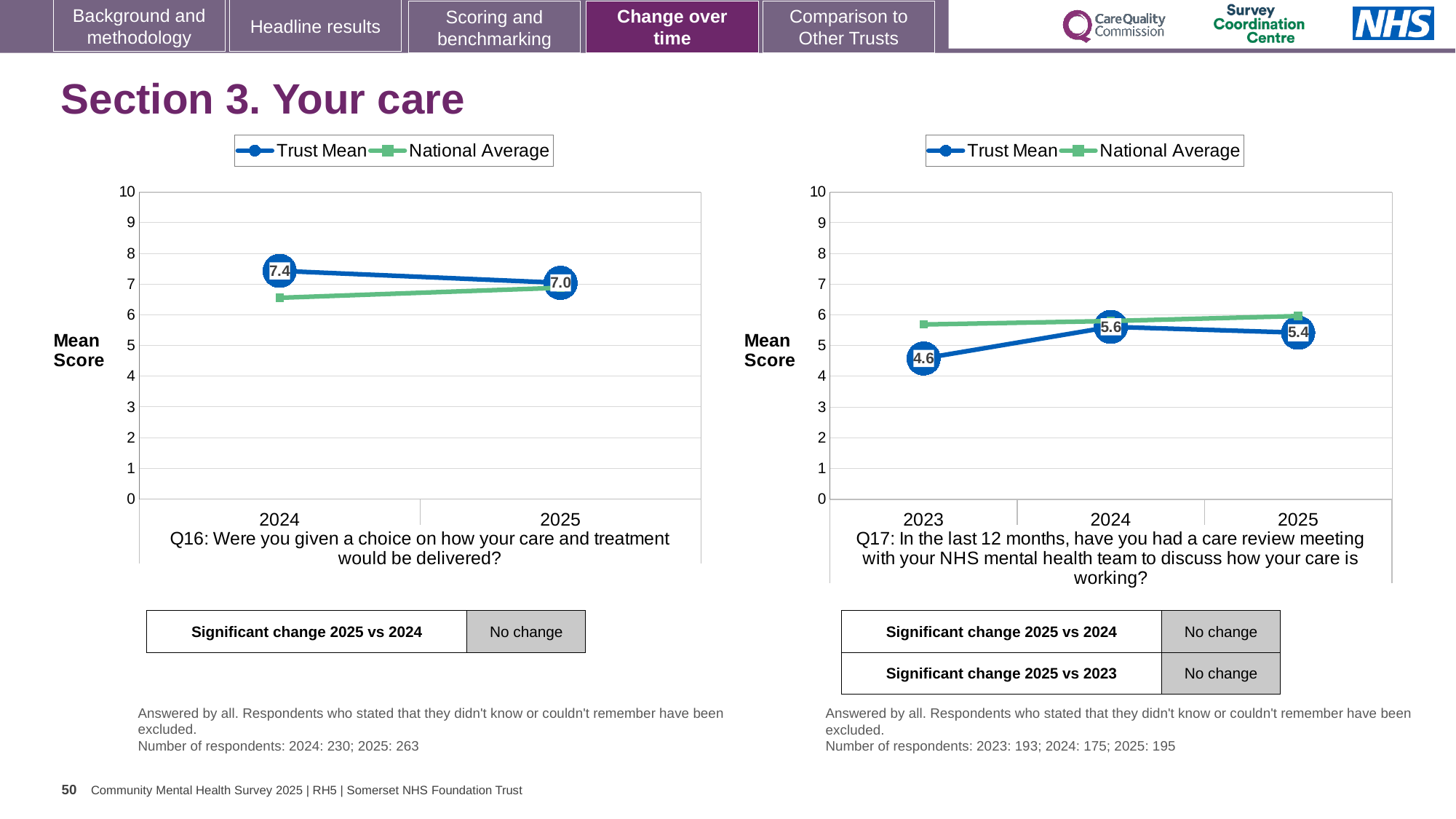
How many years are plotted on the x axis of the Q17 chart on the right? 3 In the Q16 chart on the left, is the National Average for 2024 greater or less than 7? less In the Q17 chart on the right, what is the Trust Mean score for 2023? 4.6 In the Q17 chart on the right, in 2023 which is higher, the Trust Mean or the National Average? National Average In the Q16 chart on the left, what is the Trust Mean score for 2025? 7.0 In the Q17 chart on the right, which year has the highest Trust Mean score? 2024 In the Q16 chart on the left, what is the Trust Mean score for 2024? 7.4 In the Q17 chart on the right, which year has the lowest Trust Mean score? 2023 In the Q17 chart on the right, what is the Trust Mean score for 2025? 5.4 How many series does the legend of the Q16 chart on the left list? 2 In the Q17 chart on the right, what is the difference between the Trust Mean scores for 2024 and 2023? 1.0 In the Q16 chart on the left, by how much did the Trust Mean score change from 2024 to 2025? 0.4